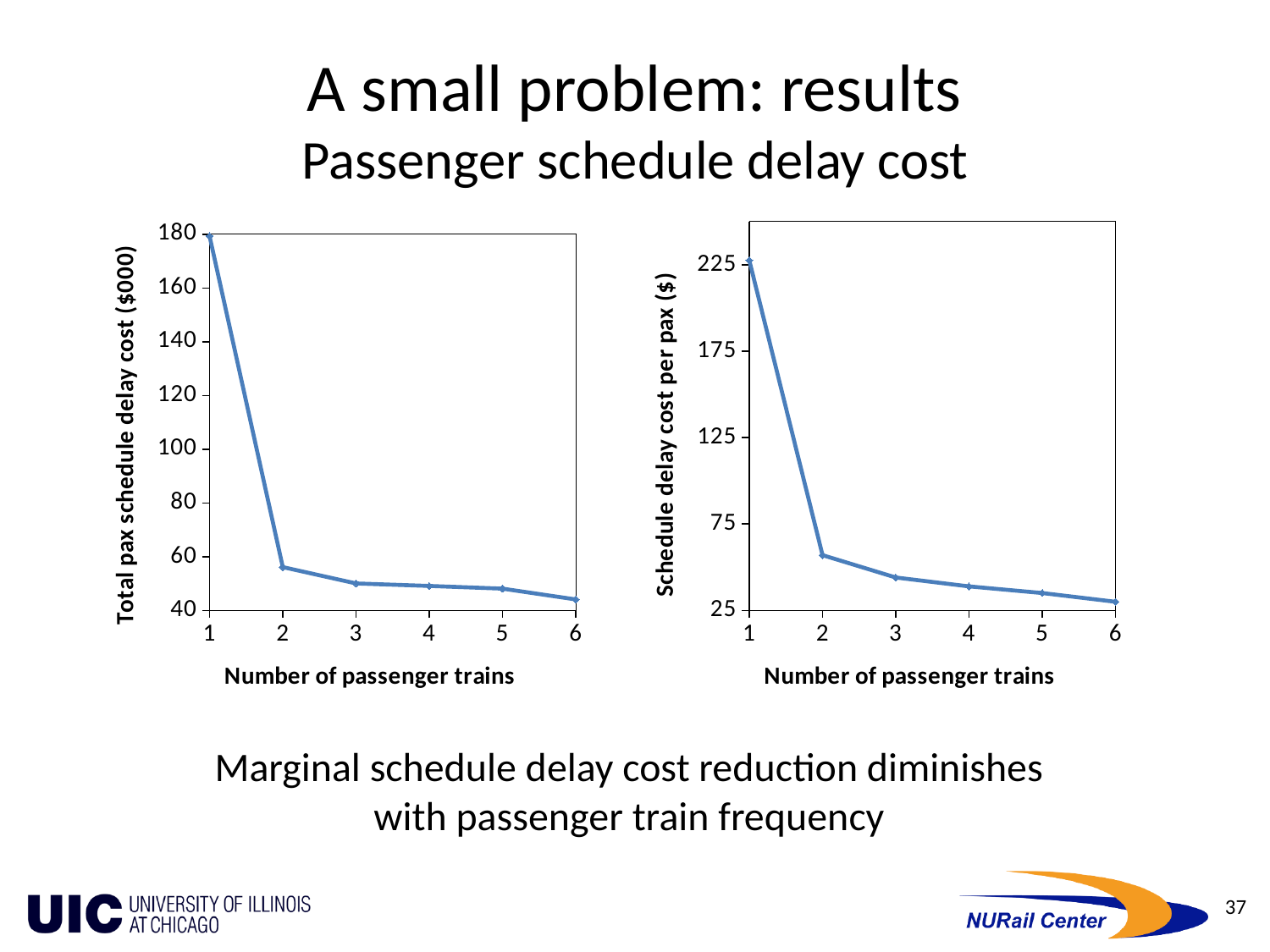
In the left chart (Total pax schedule delay cost), at which number of passenger trains is the cost lowest? 6 In the left chart (Total pax schedule delay cost), is the value for 3 passenger trains greater or less than 40? greater What is the x-axis label of the right chart (Schedule delay cost per pax)? Number of passenger trains In the left chart (Total pax schedule delay cost), at which number of passenger trains is the cost highest? 1 In the right chart (Schedule delay cost per pax), is the value for 2 passenger trains greater or less than 75? less In the right chart (Schedule delay cost per pax), at which number of passenger trains is the cost per passenger highest? 1 In the left chart (Total pax schedule delay cost), is the value for 2 passenger trains greater or less than 60? less In the left chart (Total pax schedule delay cost), how many data points are plotted? 6 In the right chart (Schedule delay cost per pax), which is larger: the value for 2 passenger trains or for 3 passenger trains? 2 passenger trains In the left chart (Total pax schedule delay cost), does the cost rise or fall as the number of passenger trains increases? fall What kind of chart is the left chart (Total pax schedule delay cost)? line chart